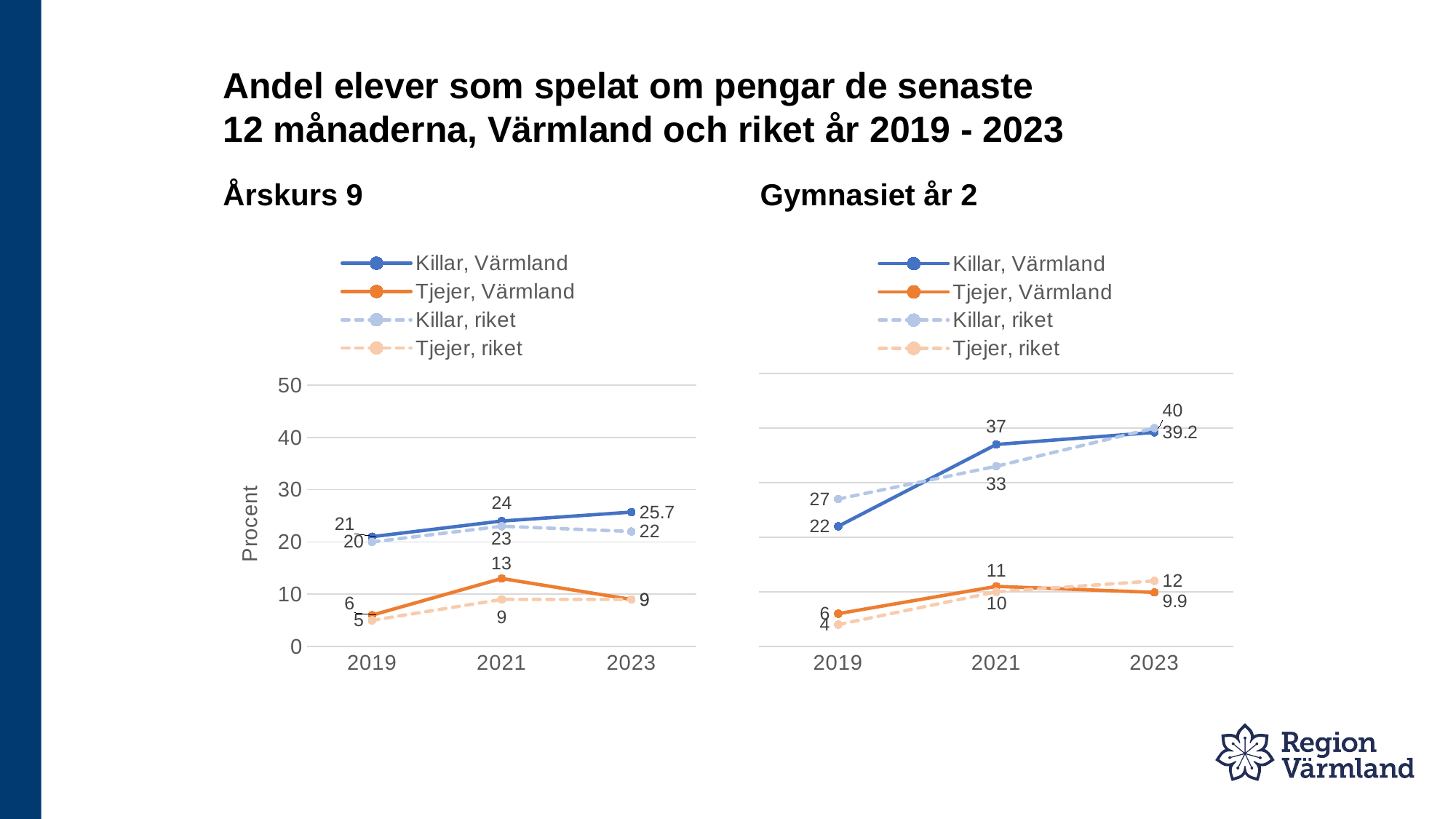
In the Gymnasiet år 2 chart, what is the value for Killar, riket in 2023? 40 In the Gymnasiet år 2 chart, what is the difference between Killar, Värmland in 2021 and 2019? 15 What kind of chart is the Årskurs 9 chart? line chart In the Gymnasiet år 2 chart, does the value for Killar, Värmland rise or fall from 2019 to 2023? rise In the Gymnasiet år 2 chart, in which year is Killar, Värmland lowest? 2019 In the Årskurs 9 chart, what is the difference between Killar, Värmland and Killar, riket in 2021? 1 How many series does the legend of the Gymnasiet år 2 chart list? 4 In the Årskurs 9 chart, what is the value for Tjejer, Värmland in 2021? 13 In the Gymnasiet år 2 chart, what is the value for Tjejer, Värmland in 2023? 9.9 How many years are shown on the x axis of the Årskurs 9 chart? 3 In the Gymnasiet år 2 chart, which is larger in 2019: Killar, Värmland or Killar, riket? Killar, riket In the Årskurs 9 chart, what is the value for Killar, Värmland in 2023? 25.7